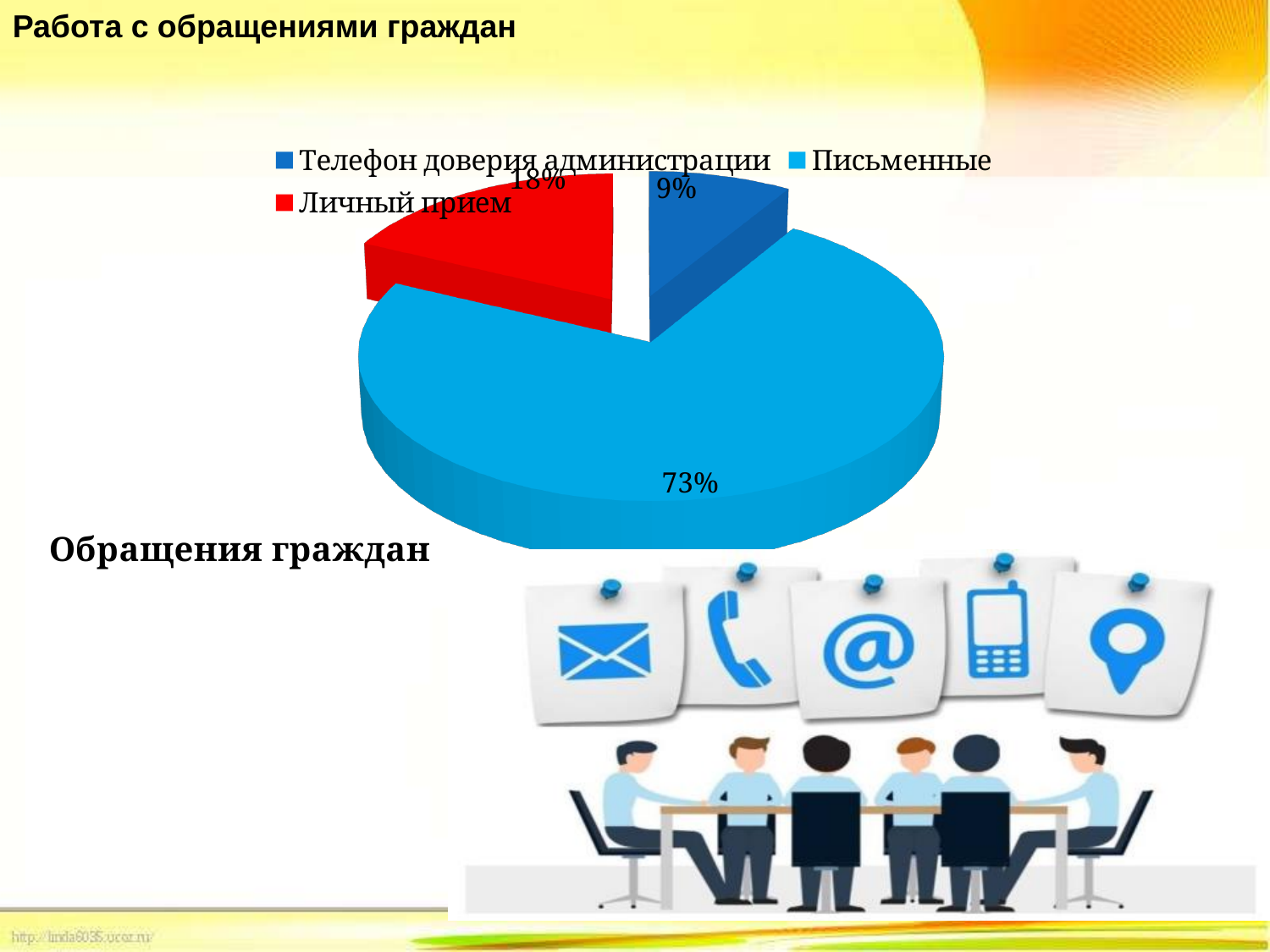
Which category has the smallest slice of the pie? Телефон доверия администрации Which category has the largest slice of the pie? Письменные What colour is the slice for "Личный прием"? red Which is larger: the slice for "Личный прием" or the slice for "Телефон доверия администрации"? Личный прием What is the difference in percentage points between "Личный прием" and "Телефон доверия администрации"? 9 What share of the pie does "Телефон доверия администрации" have? 9% What is the difference in percentage points between "Письменные" and "Личный прием"? 55 How many slices does the pie chart have? 3 What kind of chart is shown on the slide? pie chart How many entries does the legend list? 3 What share of the pie does "Личный прием" have? 18% What share of the pie does "Письменные" have? 73%